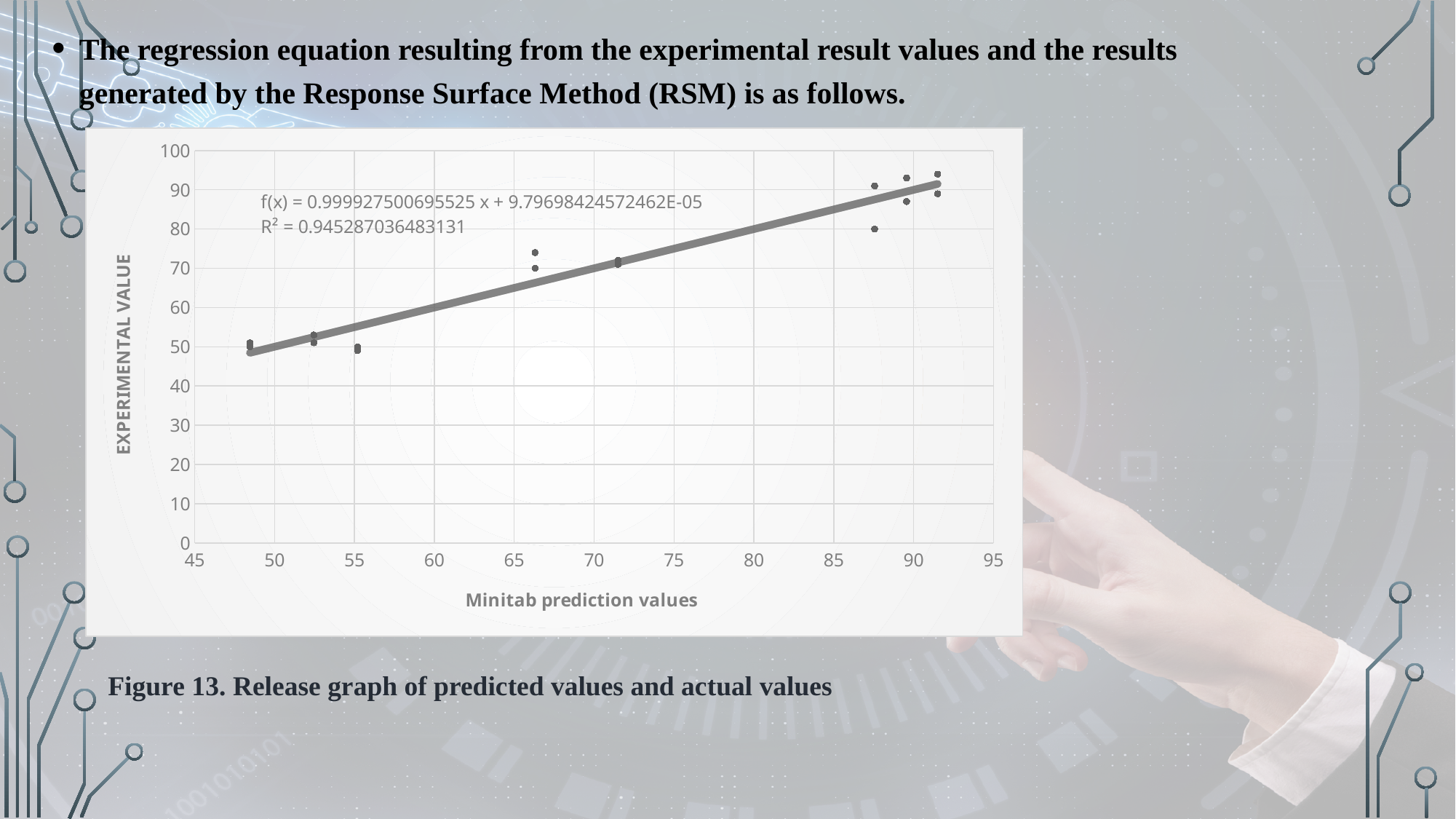
What R² value is printed on the chart? 0.945287036483131 What is the slope (coefficient of x) in the trendline equation printed on the chart? 0.999927500695525 What is the intercept in the trendline equation printed on the chart? 9.79698424572462E-05 What is the title of the y axis of the chart? EXPERIMENTAL VALUE What is the minimum value shown on the x axis of the chart? 45 Are the experimental values for the points plotted near a Minitab prediction value of 52.5 greater or less than 40? greater Do the experimental values rise or fall as the Minitab prediction values increase along the x axis? rise Are the experimental values for the points plotted near a Minitab prediction value of 91.5 greater or less than 80? greater Are the experimental values for the points plotted near a Minitab prediction value of 66 greater or less than 60? greater What is the maximum value shown on the y axis of the chart? 100 What is the title of the x axis of the chart? Minitab prediction values What kind of chart is shown on the slide? scatter chart